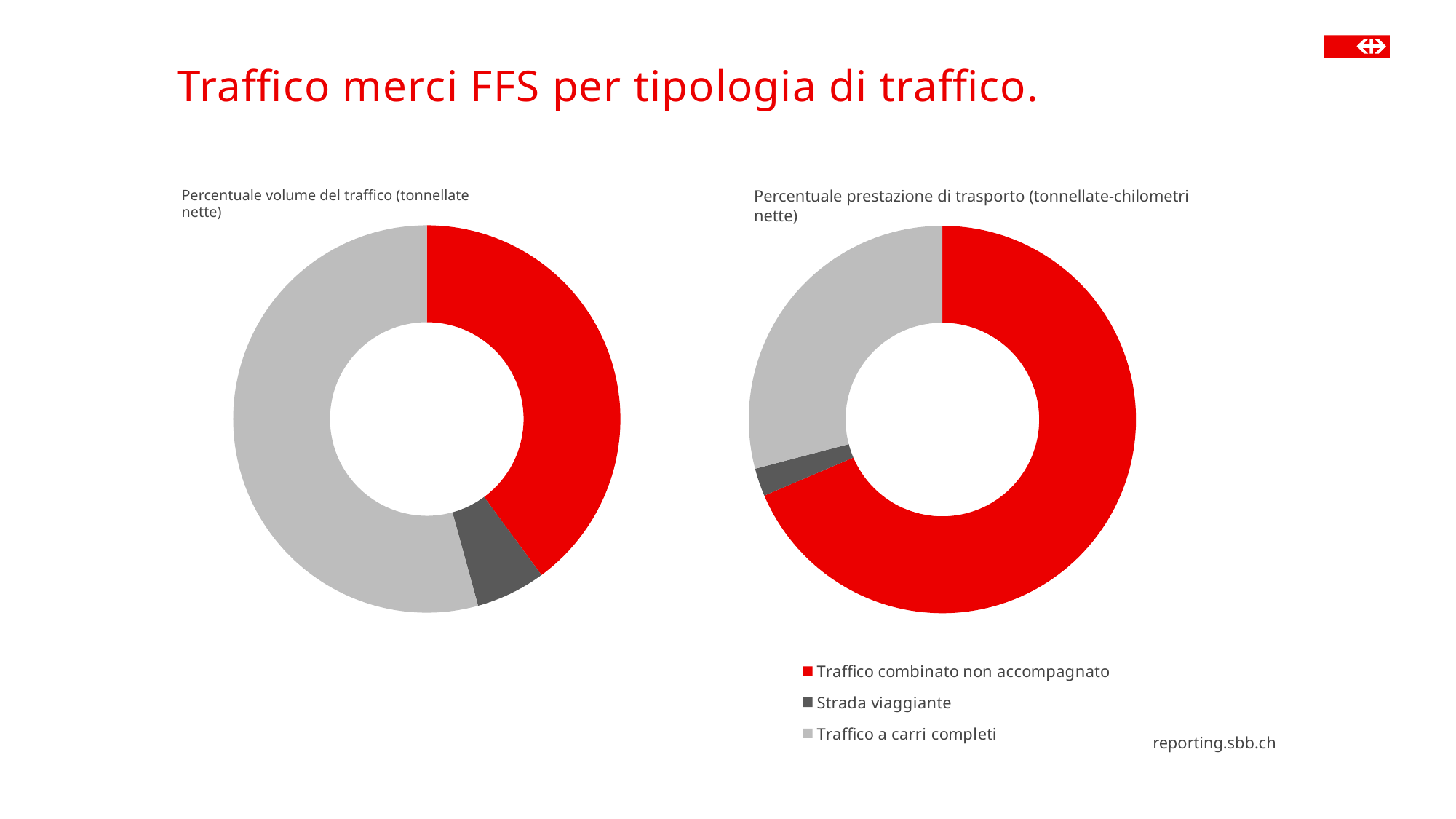
In the chart 'Percentuale volume del traffico (tonnellate nette)', how many slices are there? 3 What kind of chart is used on this slide for both charts? doughnut (pie) chart In the chart 'Percentuale prestazione di trasporto (tonnellate-chilometri nette)', which category has the smallest share? Strada viaggiante How many categories does the legend list? 3 In the chart 'Percentuale volume del traffico (tonnellate nette)', which category has the smallest share? Strada viaggiante In the left chart (volume del traffico), which is larger: Traffico combinato non accompagnato or Traffico a carri completi? Traffico a carri completi In the right chart (prestazione di trasporto), how many slices are there? 3 In the right chart (prestazione di trasporto), which is larger: Traffico combinato non accompagnato or Traffico a carri completi? Traffico combinato non accompagnato What is the title of the slide? Traffico merci FFS per tipologia di traffico. In the chart 'Percentuale prestazione di trasporto (tonnellate-chilometri nette)', which category has the largest share? Traffico combinato non accompagnato In the chart 'Percentuale volume del traffico (tonnellate nette)', which category has the largest share? Traffico a carri completi What colour represents Strada viaggiante in the charts? dark grey